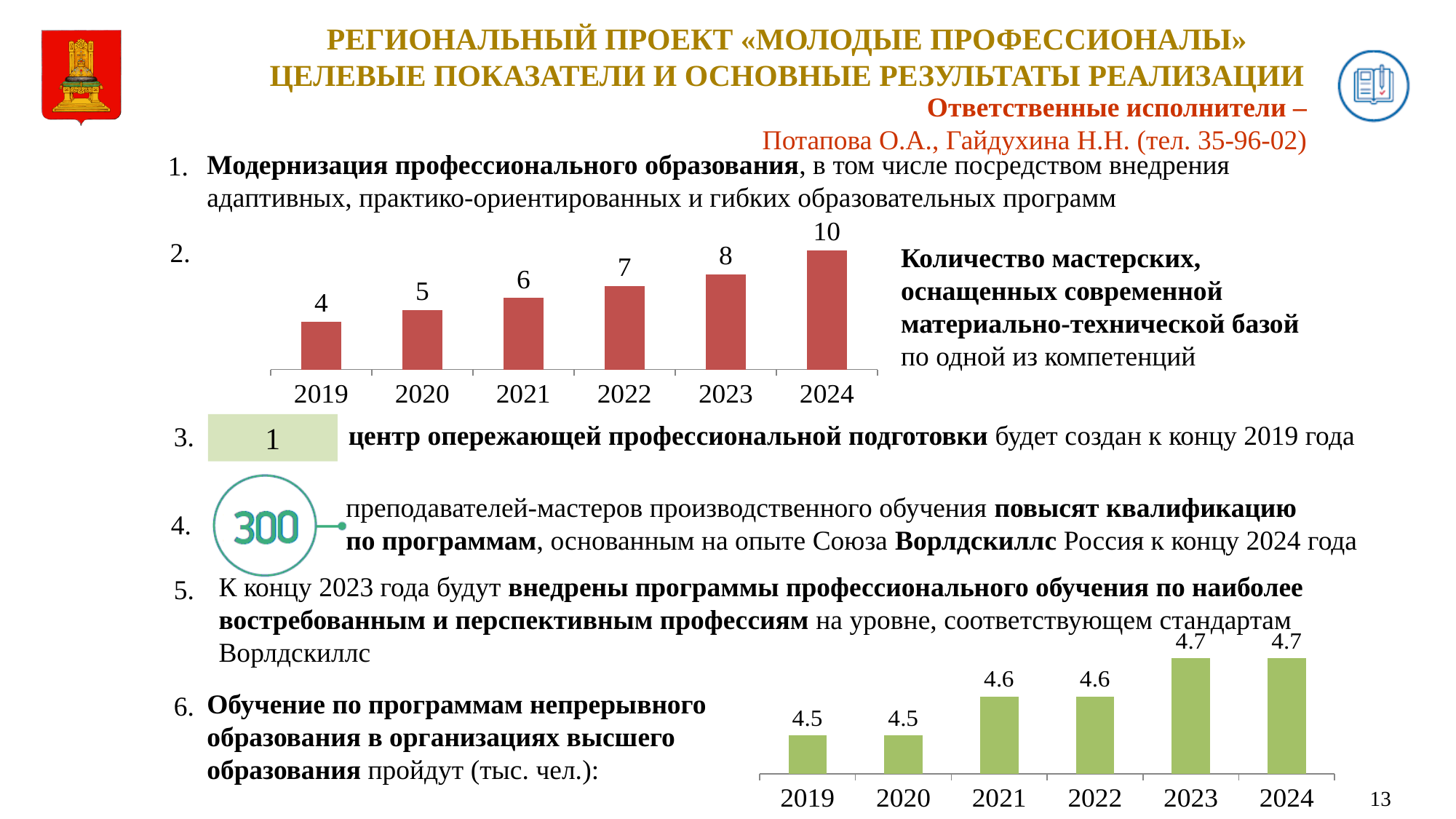
In the upper chart with red bars, what is the value for 2024? 10 In the upper chart with red bars, do the values rise or fall from 2019 to 2024? rise In the lower chart with green bars, what is the value for 2021? 4.6 In the upper chart with red bars, which year has the highest value? 2024 In the lower chart with green bars, what is the difference between the values for 2023 and 2019? 0.2 In the upper chart with red bars, how many years are shown on the x axis? 6 What type of chart is the upper chart with red bars? bar chart In the upper chart with red bars, what is the difference between the values for 2024 and 2023? 2 In the lower chart with green bars, which is larger, the value for 2022 or the value for 2020? 2022 In the upper chart with red bars, which year has the lowest value? 2019 In the upper chart with red bars, what is the value for 2019? 4 In the lower chart with green bars, what is the value for 2024? 4.7